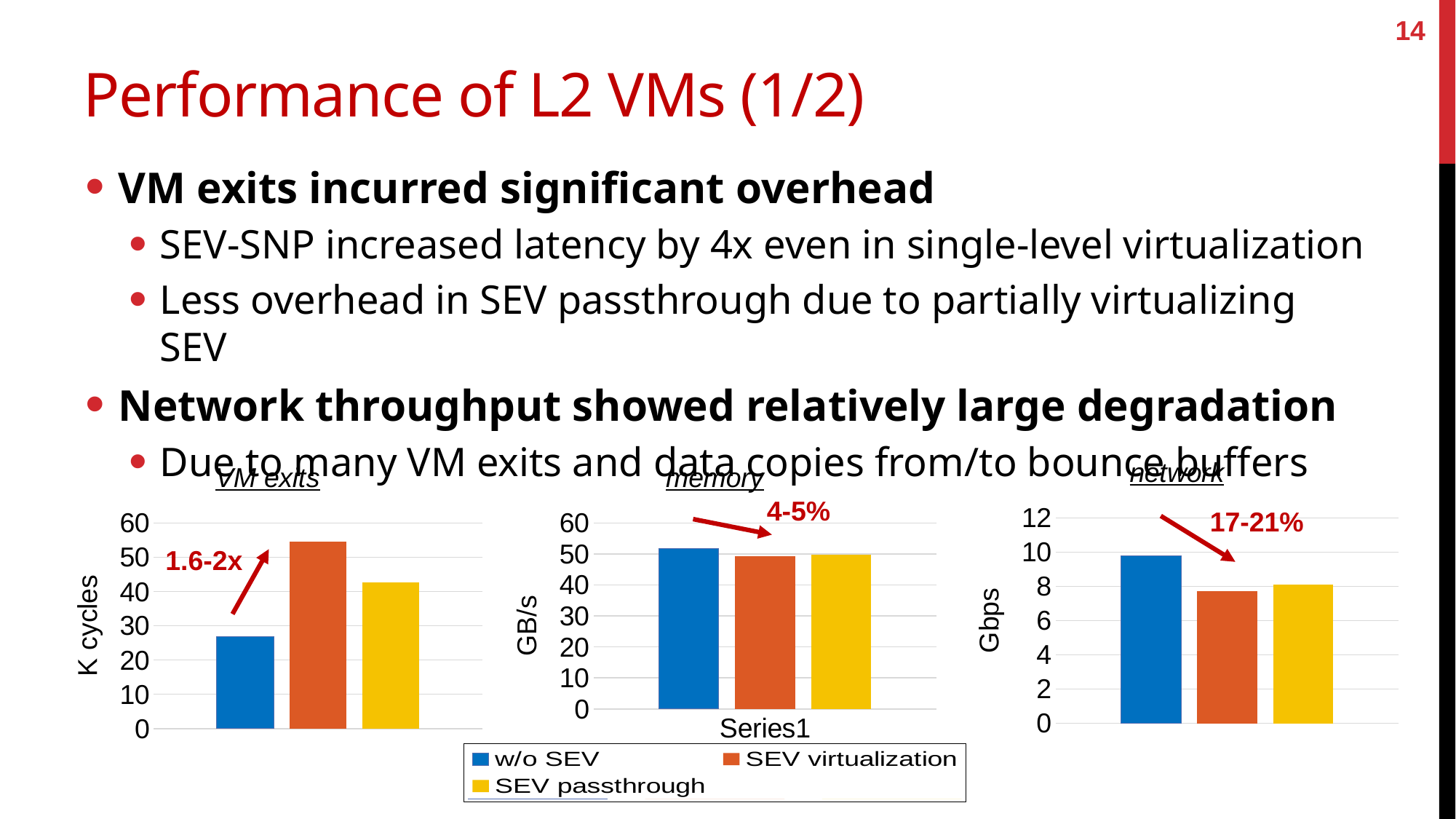
What is the y-axis label of the network chart? Gbps In the VM exits chart, which series has the lowest value? w/o SEV In the VM exits chart, is the value for SEV virtualization greater or less than 50? greater How many series does the legend list? 3 In the memory chart, is the value for w/o SEV greater or less than 50? greater What percentage degradation is annotated on the network chart? 17-21% What kind of chart is the VM exits chart? bar chart In the network chart, is the value for SEV virtualization greater or less than 8? less In the network chart, which series has the highest value? w/o SEV In the VM exits chart, which series has the highest value? SEV virtualization In the VM exits chart, which is larger: SEV passthrough or w/o SEV? SEV passthrough